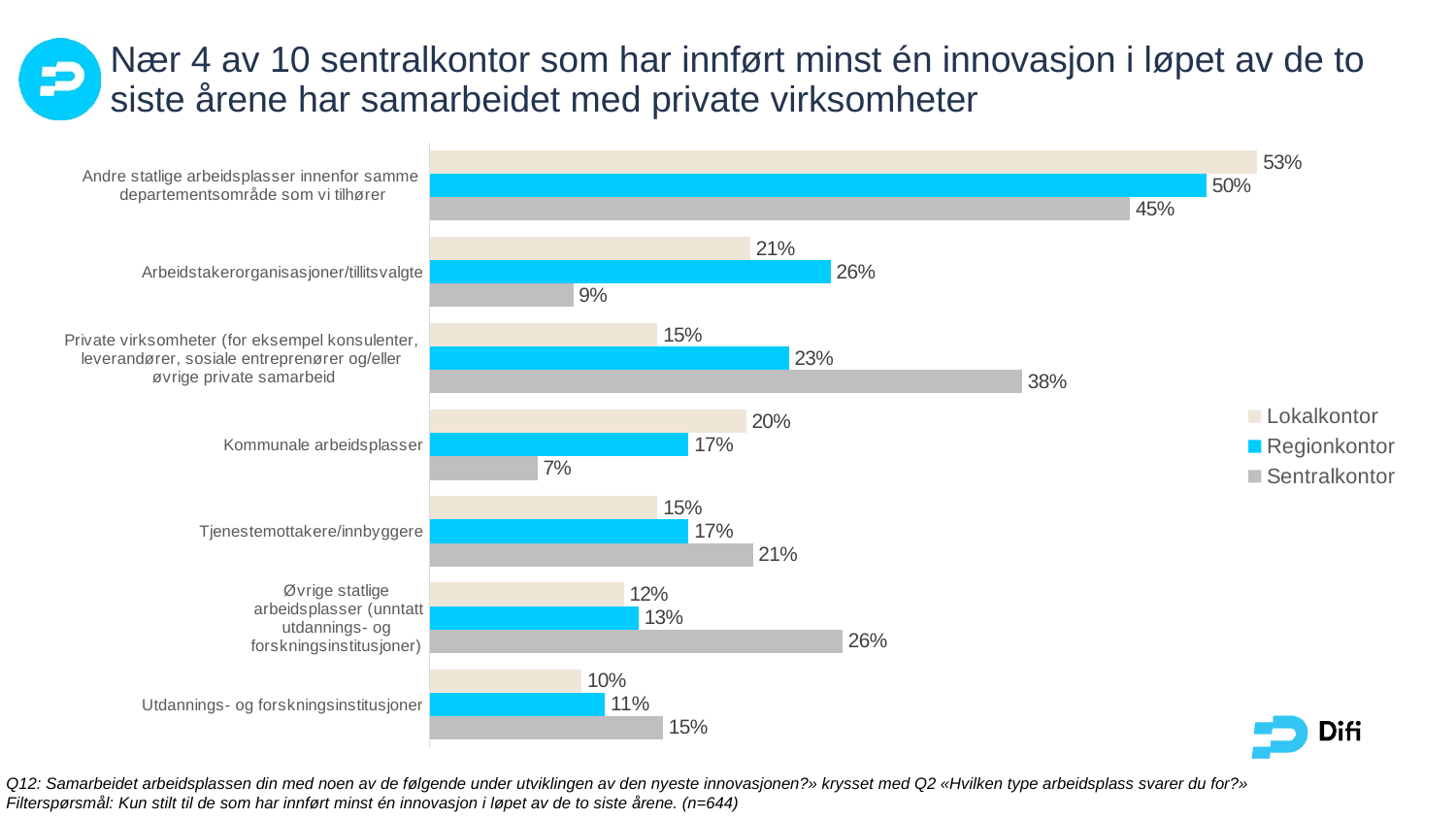
Which category has the lowest Sentralkontor value? Kommunale arbeidsplasser What kind of chart is shown on the slide? Bar chart What is the Sentralkontor value for "Private virksomheter (for eksempel konsulenter, leverandører, sosiale entreprenører og/eller øvrige private samarbeid"? 38% Which category has the highest Lokalkontor value? Andre statlige arbeidsplasser innenfor samme departementsområde som vi tilhører What is the Lokalkontor value for "Kommunale arbeidsplasser"? 20% How many categories are shown on the chart? 7 For "Tjenestemottakere/innbyggere", which is larger: the Regionkontor value or the Sentralkontor value? Sentralkontor What is the difference between the Lokalkontor and Sentralkontor values for "Andre statlige arbeidsplasser innenfor samme departementsområde som vi tilhører"? 8% What is the Regionkontor value for "Arbeidstakerorganisasjoner/tillitsvalgte"? 26% How many series does the legend list? 3 Which series is shown in blue in the legend? Regionkontor What is the difference between the Sentralkontor and Lokalkontor values for "Private virksomheter (for eksempel konsulenter, leverandører, sosiale entreprenører og/eller øvrige private samarbeid"? 23%